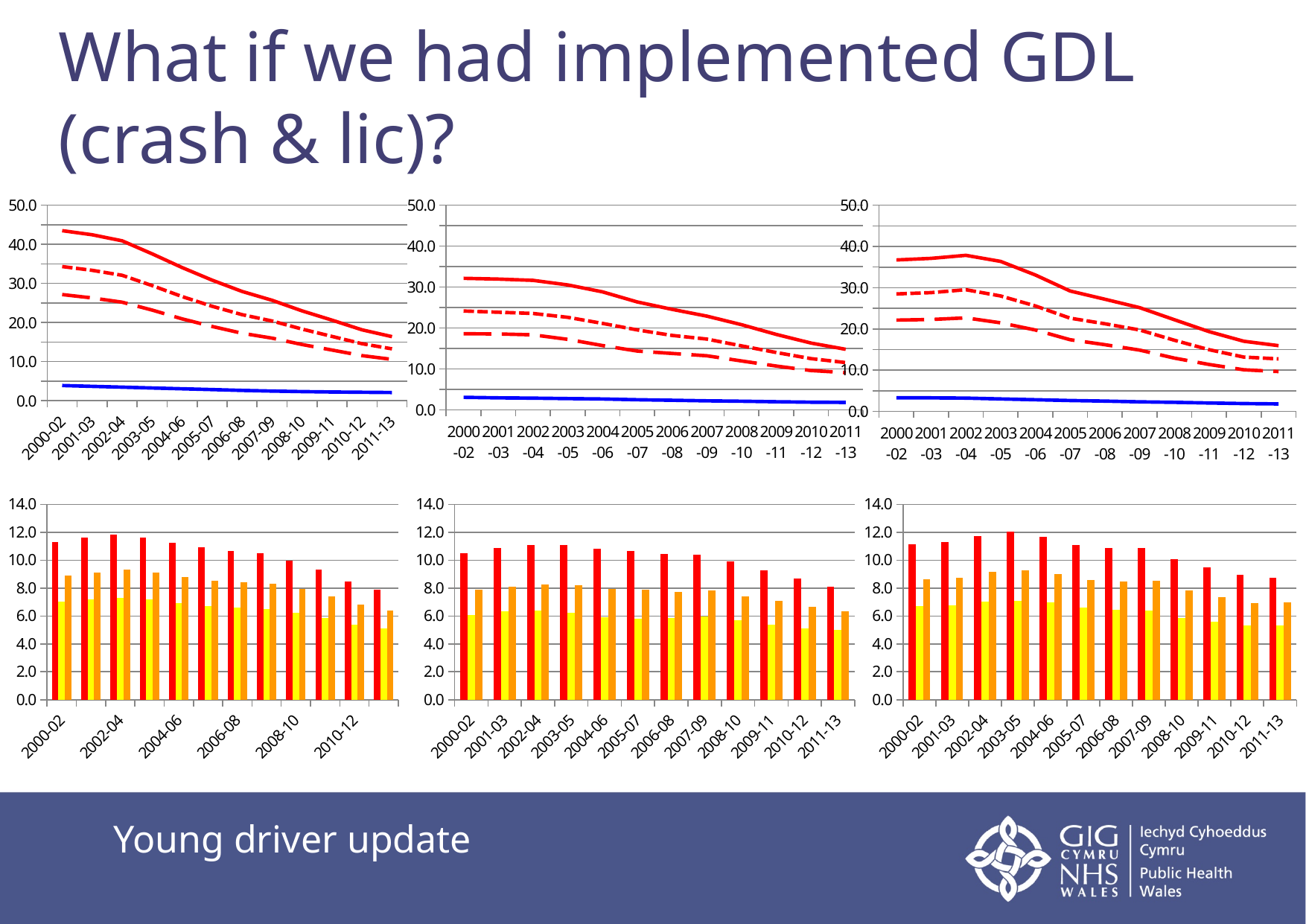
In the top-left line chart, how many time periods are shown along the x axis? 12 In the top-left line chart, which is larger at 2000-02: the solid red line or the blue line? the solid red line In the top-left line chart, is the value of the solid red line for 2000-02 greater or less than 40.0? greater In the bottom-left bar chart, which period has the tallest red bar? 2002-04 In the top-right line chart, is the value of the blue line for 2000-02 greater or less than 10.0? less In the bottom-middle bar chart, is the red bar for 2011-13 greater or less than 10.0? less In the bottom-right bar chart, which is larger: the red bar for 2000-02 or the red bar for 2011-13? the red bar for 2000-02 What kind of chart is the bottom-left chart on the slide? bar chart In the bottom-left bar chart, which period has the shortest red bar? 2011-13 In the top-left line chart, does the solid red line rise or fall from 2000-02 to 2011-13? fall What kind of chart is the top-left chart on the slide? line chart